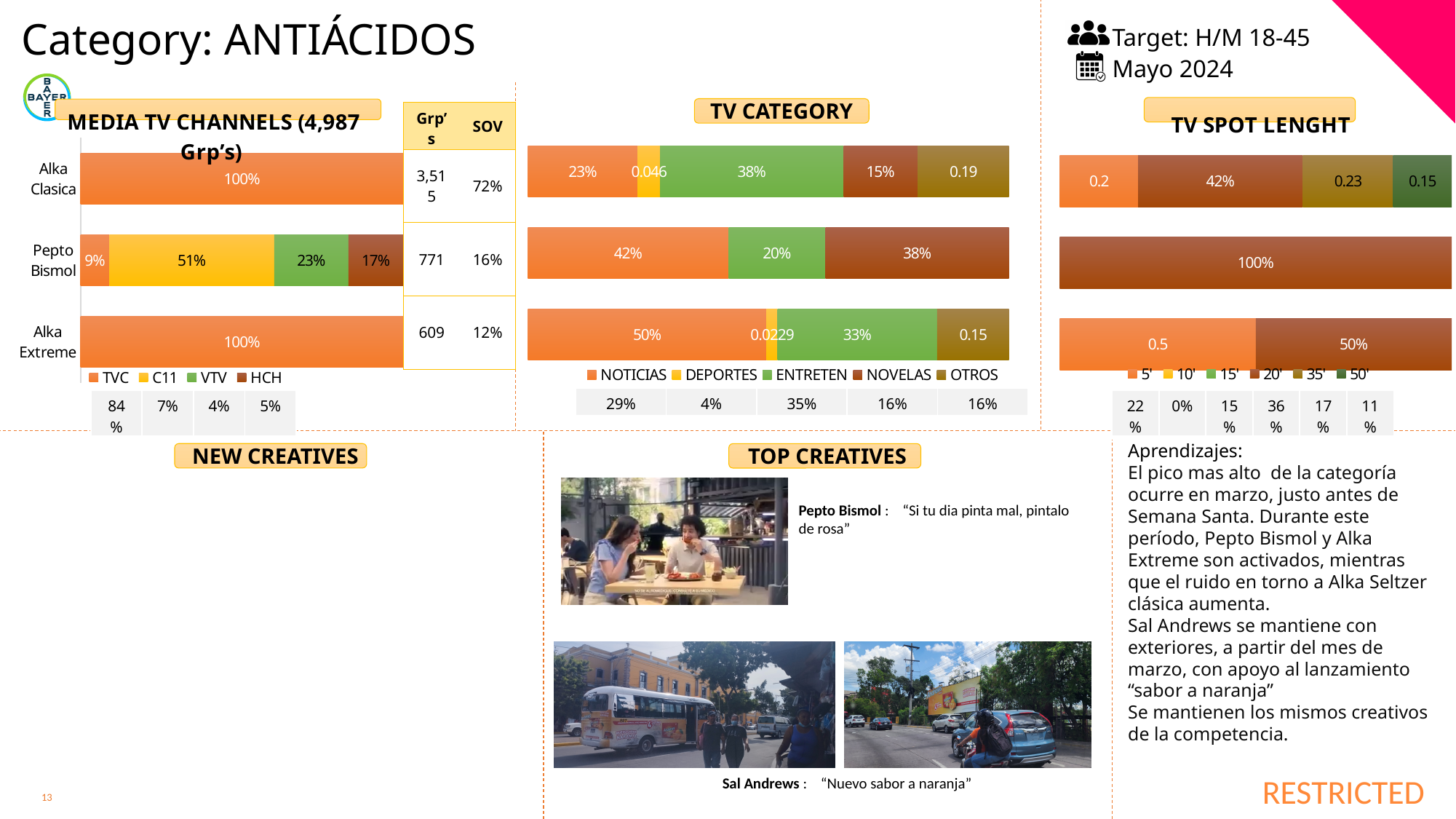
How many series does the legend of the TV SPOT LENGHT chart list? 6 In the TV CATEGORY chart, what is the NOTICIAS value in the bottom bar? 50% In the TV CATEGORY chart, what is the NOVELAS value in the middle bar? 38% In the MEDIA TV CHANNELS chart, what is the C11 value for Pepto Bismol? 51% In the TV SPOT LENGHT chart, what is the 20' value in the top bar? 42% In the MEDIA TV CHANNELS chart, what is the difference between the VTV and HCH values for Pepto Bismol? 6% In the MEDIA TV CHANNELS chart, for Pepto Bismol, which is larger: VTV or HCH? VTV How many series does the legend of the TV CATEGORY chart list? 5 In the MEDIA TV CHANNELS chart, which channel has the largest share for Pepto Bismol? C11 What kind of chart is the MEDIA TV CHANNELS chart? bar chart How many brands (categories) are shown in the MEDIA TV CHANNELS chart? 3 How many series does the legend of the MEDIA TV CHANNELS chart list? 4